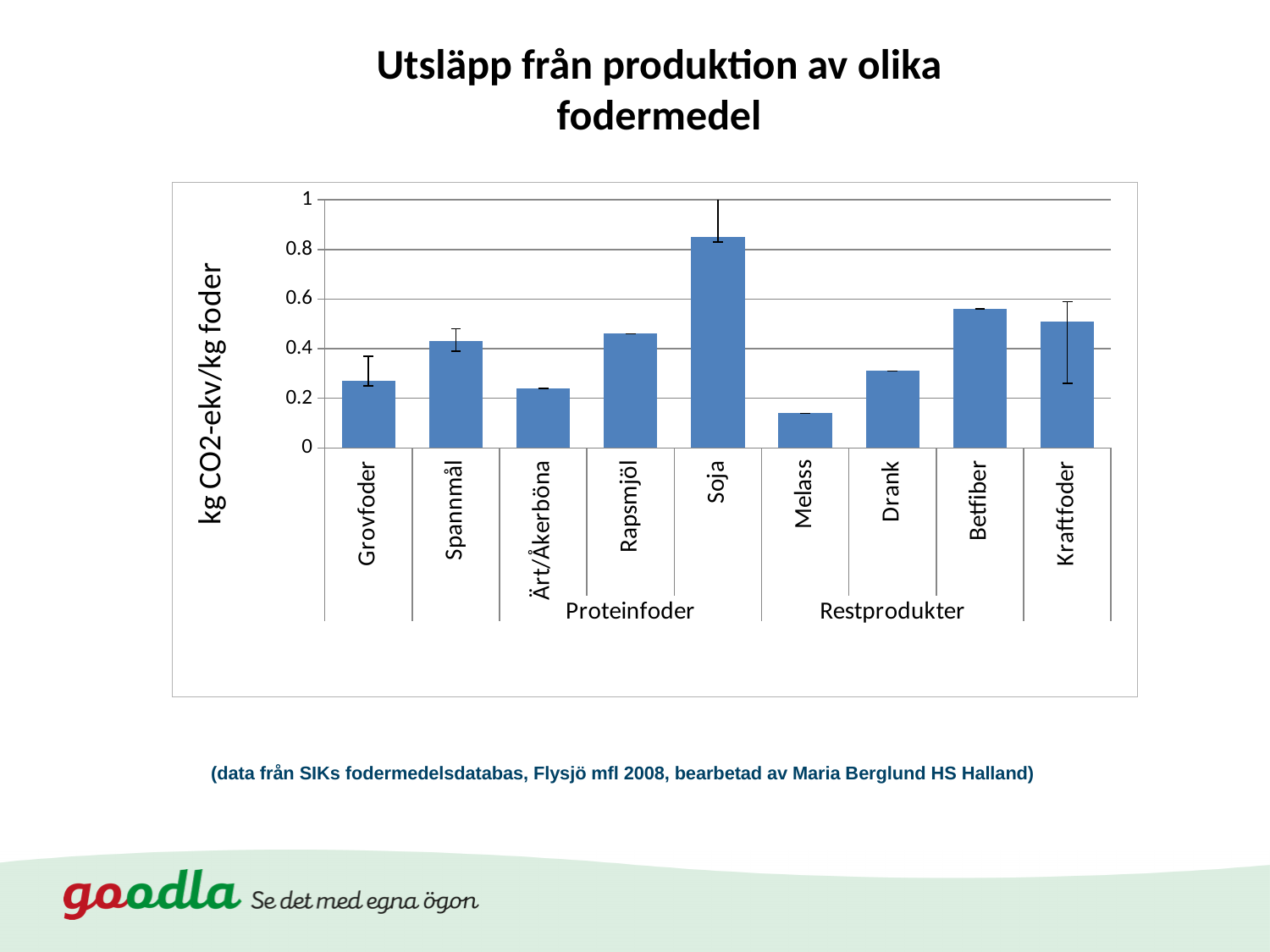
Is the value for Melass greater or less than 0.2? less Which has higher emissions, Spannmål or Ärt/Åkerböna? Spannmål Is the value for Betfiber greater or less than 0.6? less What kind of chart is shown on the slide? bar chart Which has higher emissions, Melass or Drank? Drank Is the value for Soja greater or less than 0.8? greater How many feed categories are plotted in the chart? 9 Which feed category has the highest emissions in the chart? Soja What is the label on the vertical axis of the chart? kg CO2-ekv/kg foder Which feed category has the lowest emissions in the chart? Melass